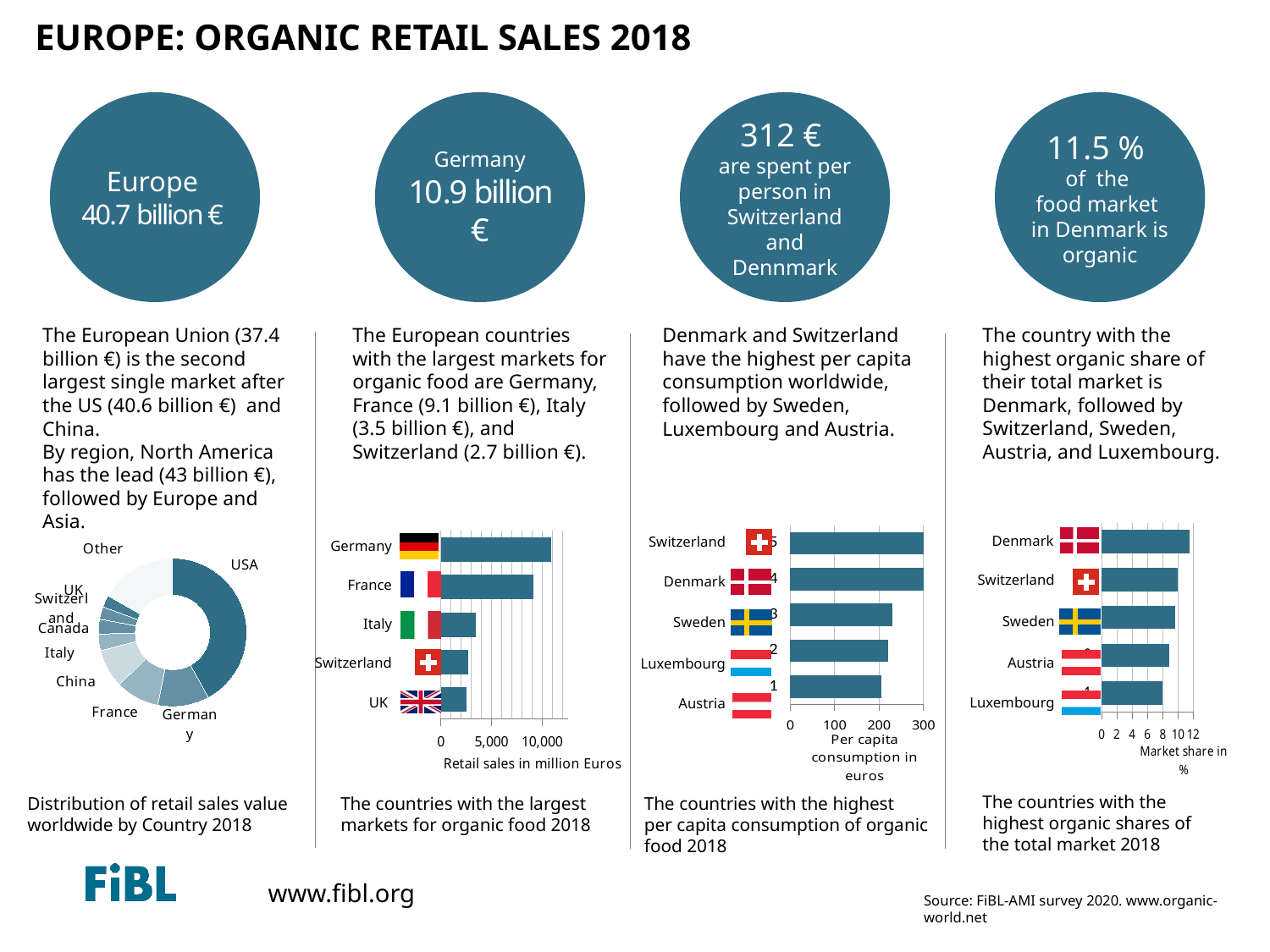
In the chart 'The countries with the highest per capita consumption of organic food 2018', is the value for Sweden greater or less than 300? less In the chart 'The countries with the highest organic shares of the total market 2018', which country has the lowest market share? Luxembourg In the chart 'The countries with the highest per capita consumption of organic food 2018', what is the x-axis title? Per capita consumption in euros In the chart 'The countries with the largest markets for organic food 2018', how many countries are shown? 5 In the chart 'The countries with the largest markets for organic food 2018', is the value for France greater or less than 10,000? less What kind of chart is the chart titled 'The countries with the largest markets for organic food 2018'? bar chart In the chart 'The countries with the highest per capita consumption of organic food 2018', how many countries are shown? 5 In the chart 'The countries with the highest organic shares of the total market 2018', is the value for Denmark greater or less than 10? greater In the chart 'Distribution of retail sales value worldwide by Country 2018', which country has the largest slice? USA In the chart 'The countries with the largest markets for organic food 2018', which country has the highest retail sales? Germany In the chart 'The countries with the largest markets for organic food 2018', which has the larger retail sales, France or Italy? France In the chart 'The countries with the highest organic shares of the total market 2018', which country has the highest market share? Denmark